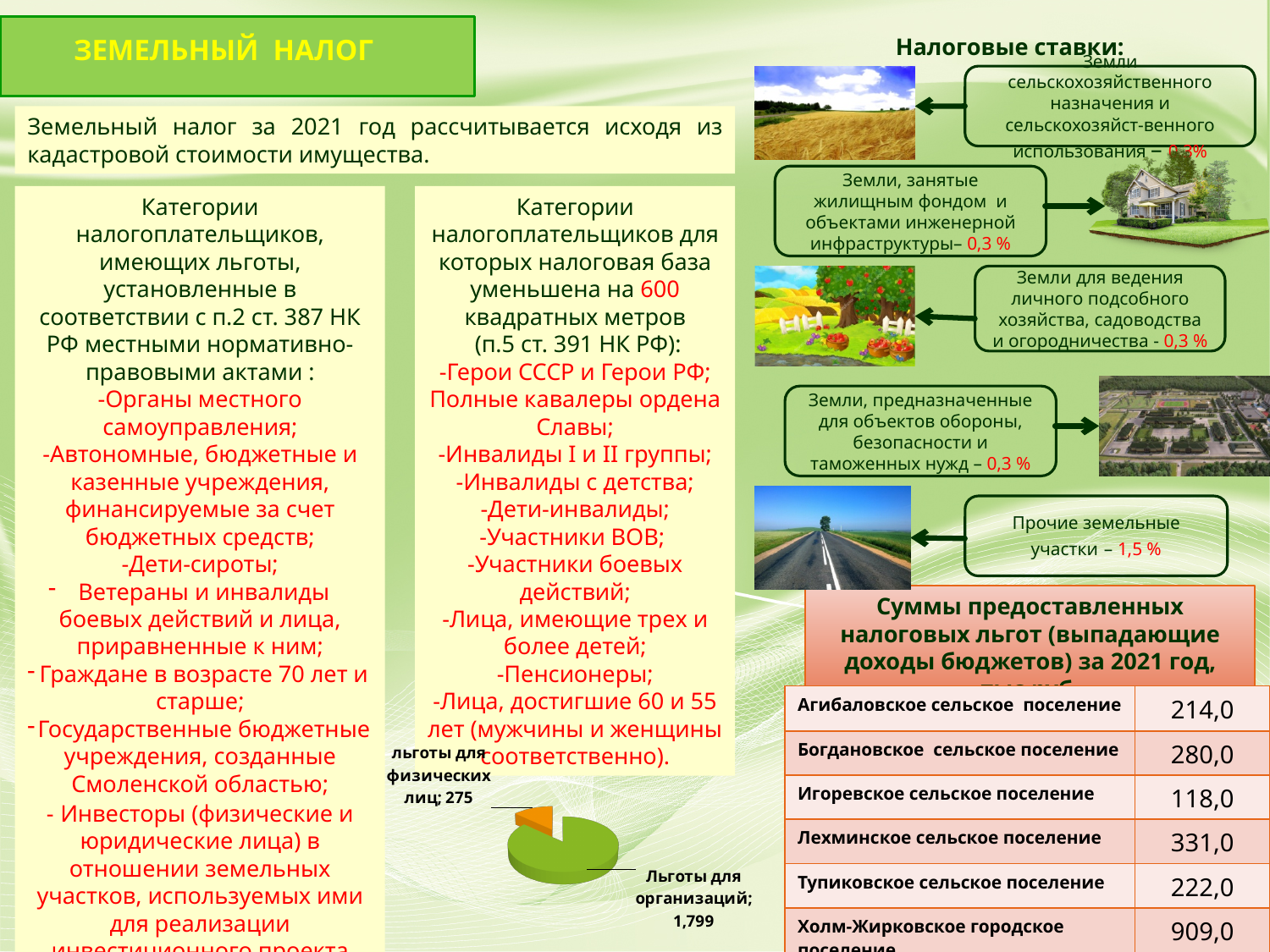
What colour is the "льготы для физических лиц" slice in the pie chart? orange What kind of chart is shown on the slide? pie chart Which slice of the pie chart is the smallest? льготы для физических лиц What colour is the "Льготы для организаций" slice in the pie chart? green Which slice of the pie chart is the largest? Льготы для организаций In the pie chart, which is larger: the value for "Льготы для организаций" or for "льготы для физических лиц"? Льготы для организаций What is the value shown for "льготы для физических лиц" in the pie chart? 275 What is the value shown for "Льготы для организаций" in the pie chart? 1,799 What is the difference between the values for "Льготы для организаций" and "льготы для физических лиц" in the pie chart? 1,524 How many slices does the pie chart have? 2 What is the total of the two values shown in the pie chart? 2,074